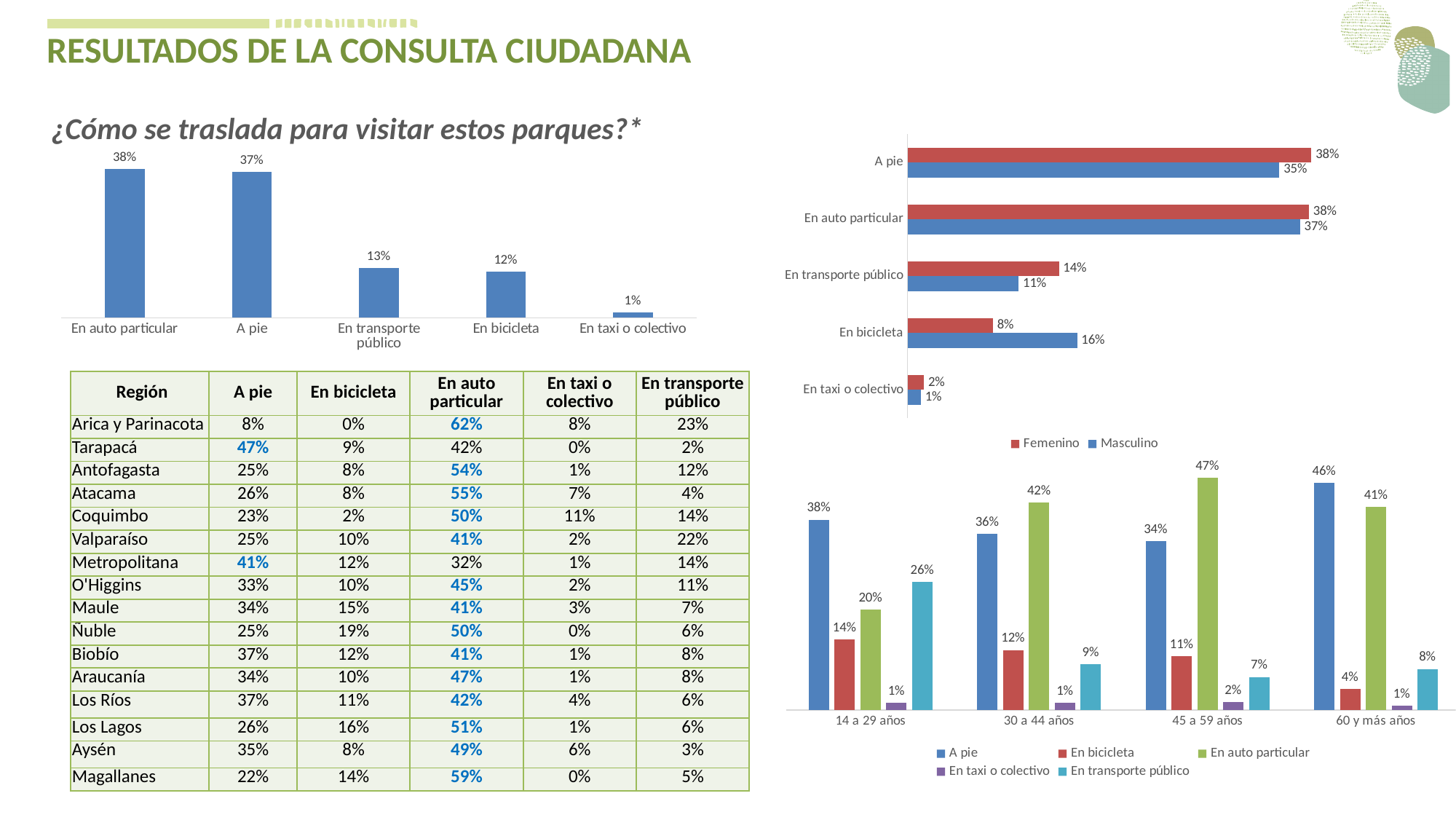
In the top-left bar chart, how many categories are shown? 5 What type of chart is the top-right chart? Bar chart In the bottom-right bar chart, which category has the highest value in the '60 y más años' group? A pie In the top-right horizontal bar chart, what is the Masculino value for 'En bicicleta'? 16% In the bottom-right bar chart, what is the value for 'En auto particular' in the '45 a 59 años' group? 47% In the bottom-right bar chart, how many series does the legend list? 5 In the top-left bar chart, what is the value for 'En transporte público'? 13% In the top-left bar chart, what is the difference between 'En auto particular' and 'En bicicleta'? 26% In the top-left bar chart, which category has the lowest value? En taxi o colectivo In the top-right horizontal bar chart, which is larger for 'En transporte público': Femenino or Masculino? Femenino In the top-right horizontal bar chart, how many series does the legend list? 2 In the top-right horizontal bar chart, what is the difference between Femenino and Masculino for 'A pie'? 3%